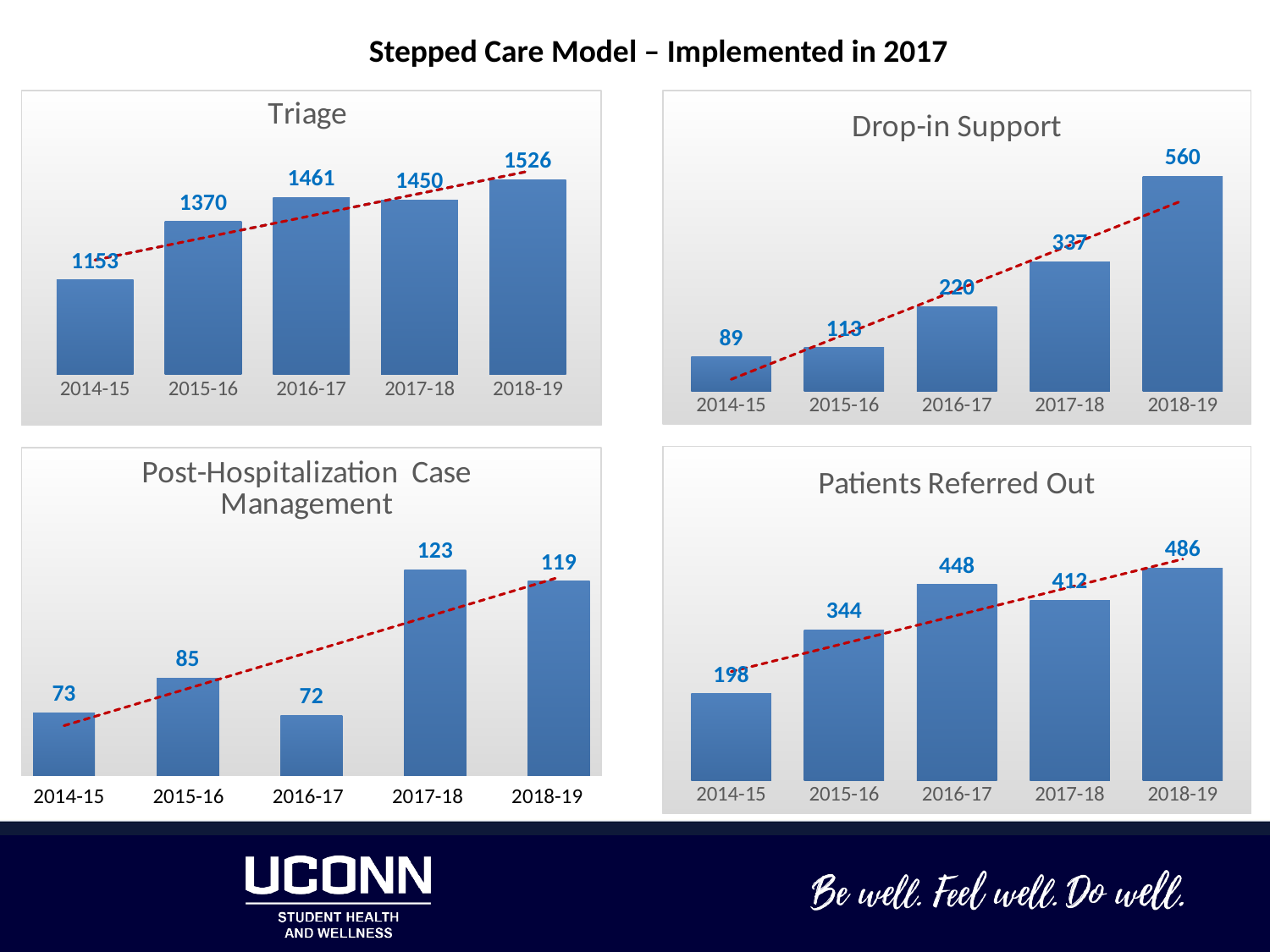
In the Post-Hospitalization Case Management chart, which year has the lowest value? 2016-17 In the Drop-in Support chart, do the values rise or fall from 2014-15 to 2018-19? rise In the Triage chart, which year has the highest value? 2018-19 What kind of chart is the Triage chart? bar chart In the Patients Referred Out chart, which is larger, the value for 2016-17 or 2017-18? 2016-17 In the Post-Hospitalization Case Management chart, what is the value for 2017-18? 123 In the Drop-in Support chart, which year has the lowest value? 2014-15 In the Triage chart, what is the value for 2016-17? 1461 How many years are shown on the x axis of the Patients Referred Out chart? 5 In the Triage chart, what is the difference between the 2018-19 and 2014-15 values? 373 In the Patients Referred Out chart, what is the value for 2015-16? 344 In the Drop-in Support chart, what is the value for 2017-18? 337